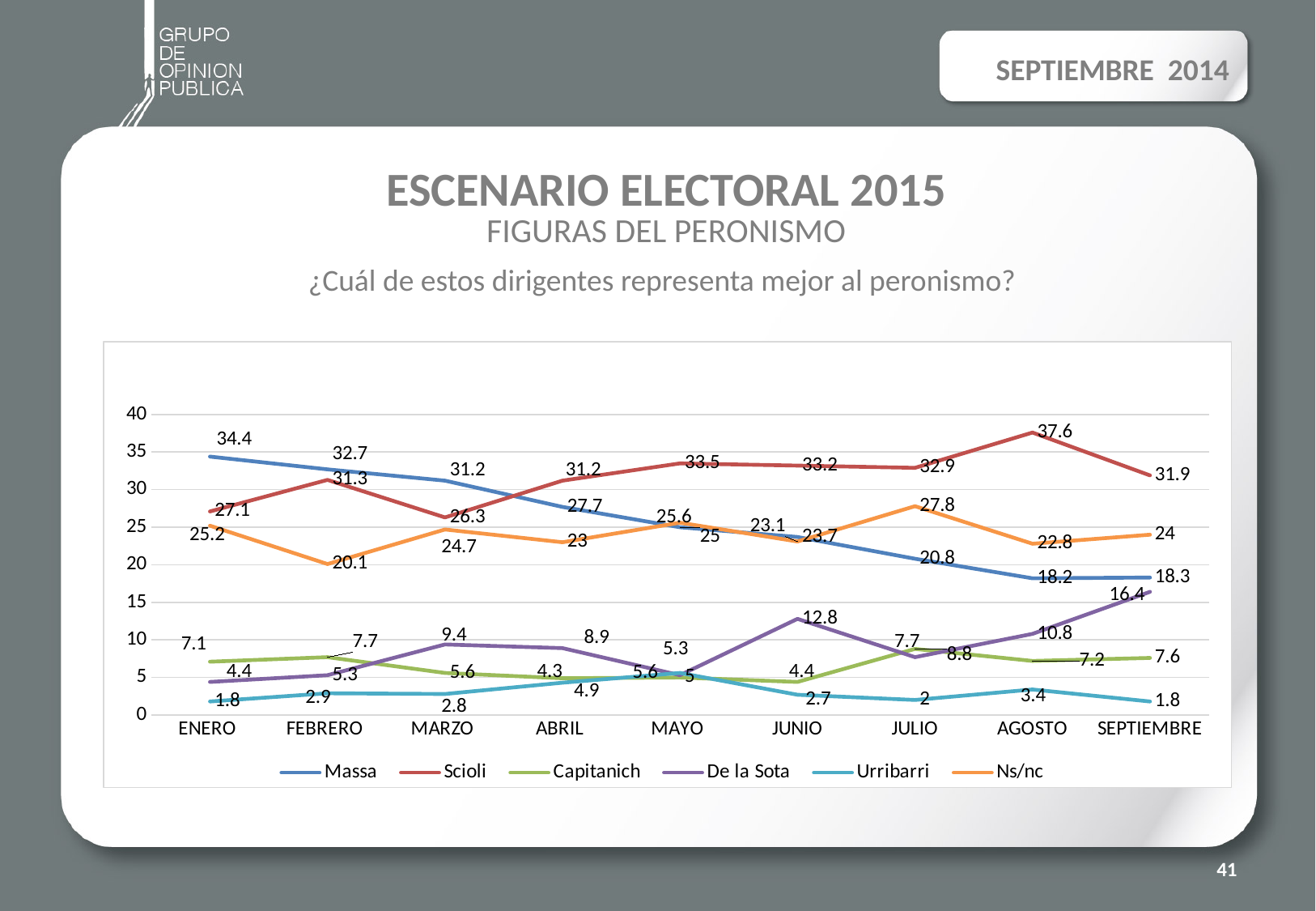
In FEBRERO, who has the larger value, Massa or Scioli? Massa How many series does the legend list? 6 What kind of chart is shown on the slide? Line chart How many months are shown on the x axis? 9 What value does Massa have in ENERO? 34.4 What value does Scioli have in AGOSTO? 37.6 In which month does Massa have his highest value? ENERO What is the difference between Scioli and Massa in SEPTIEMBRE? 13.6 Is the value for Scioli in MAYO greater or less than 30? greater What value does De la Sota have in SEPTIEMBRE? 16.4 What value does Ns/nc have in JULIO? 27.8 In which month does Scioli reach his highest value? AGOSTO